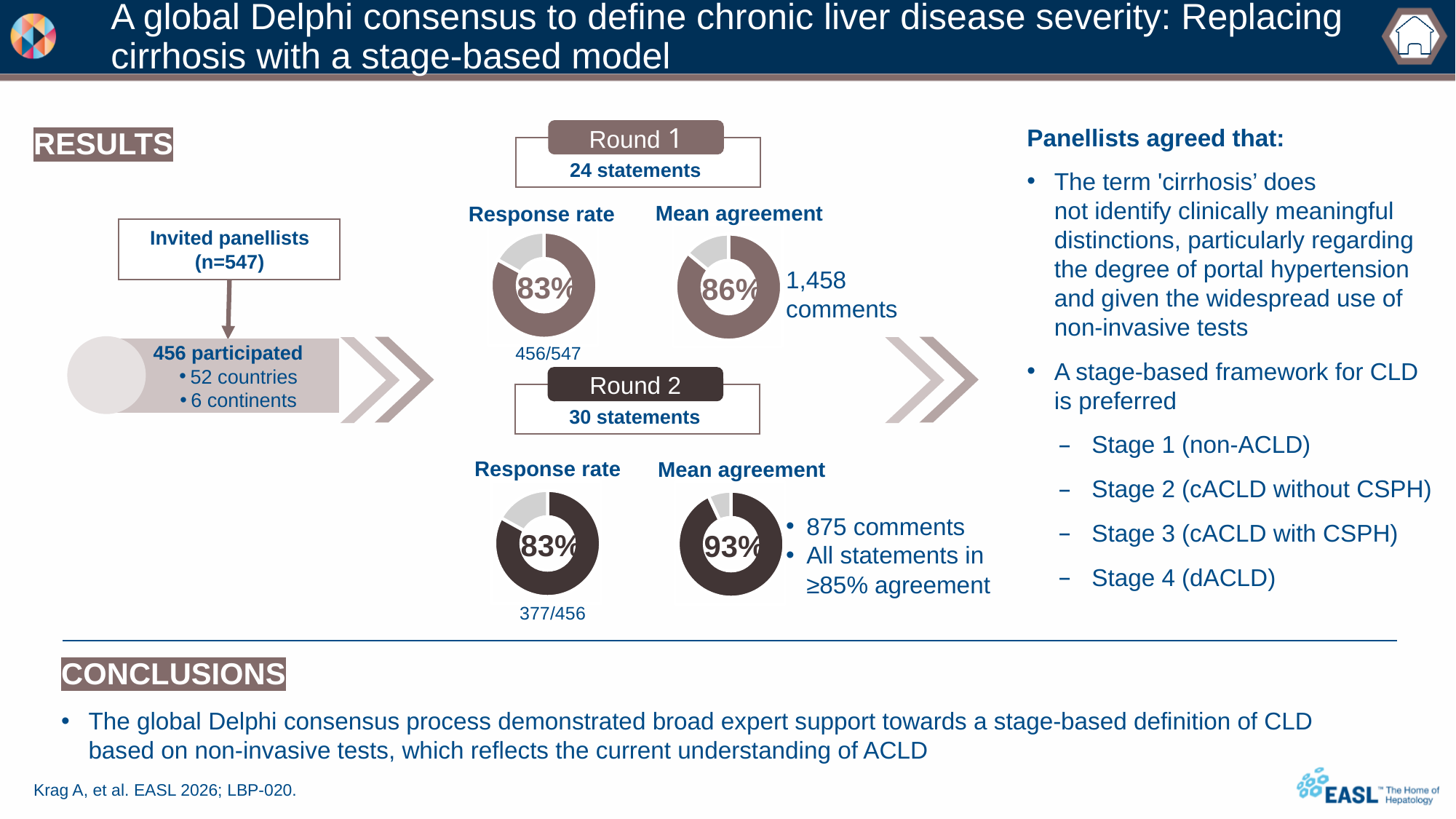
In the Round 1 mean agreement donut chart, what mean agreement is shown? 86% In the Round 1 response rate donut chart, what response rate is shown? 83% Is the Round 1 response rate and the Round 2 response rate the same value in the donut charts? Yes, both 83% In the Round 2 mean agreement donut chart, what mean agreement is shown? 93% Which round's mean agreement donut chart shows the higher value, Round 1 or Round 2? Round 2 What kind of chart is used to show the Round 1 response rate? Donut chart In the Round 2 response rate donut chart, what response rate is shown? 83% What fraction is printed below the Round 1 response rate donut chart? 456/547 Which of the four donut charts shows the highest value? Round 2 mean agreement (93%) How many donut charts are shown on the slide? 4 What is the difference between the Round 2 mean agreement and the Round 1 mean agreement shown in the donut charts? 7% What fraction is printed below the Round 2 response rate donut chart? 377/456